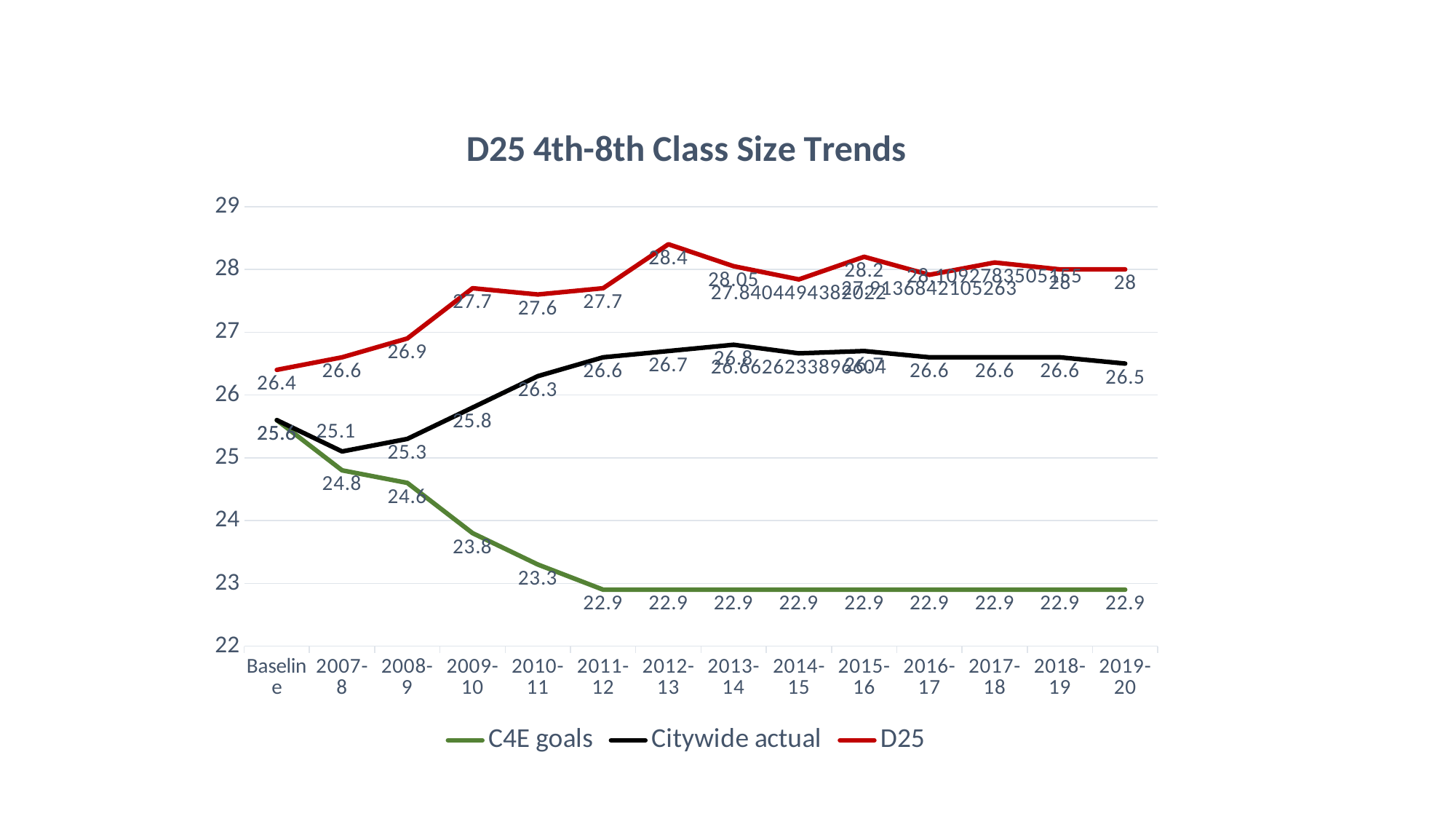
Do the C4E goals values rise or fall from Baseline to 2011-12? fall What is the Citywide actual value for 2019-20? 26.5 What is the D25 value at Baseline? 26.4 In which year is the Citywide actual value lowest? 2007-8 How many categories are shown on the x axis? 14 What is the D25 value for 2012-13? 28.4 How many series does the legend list? 3 What kind of chart is shown on the slide? line chart In which year is the D25 value highest? 2012-13 What is the difference between the D25 and Citywide actual values in 2012-13? 1.7 What is the C4E goals value for 2010-11? 23.3 Which is larger in 2008-9, the D25 value or the Citywide actual value? D25